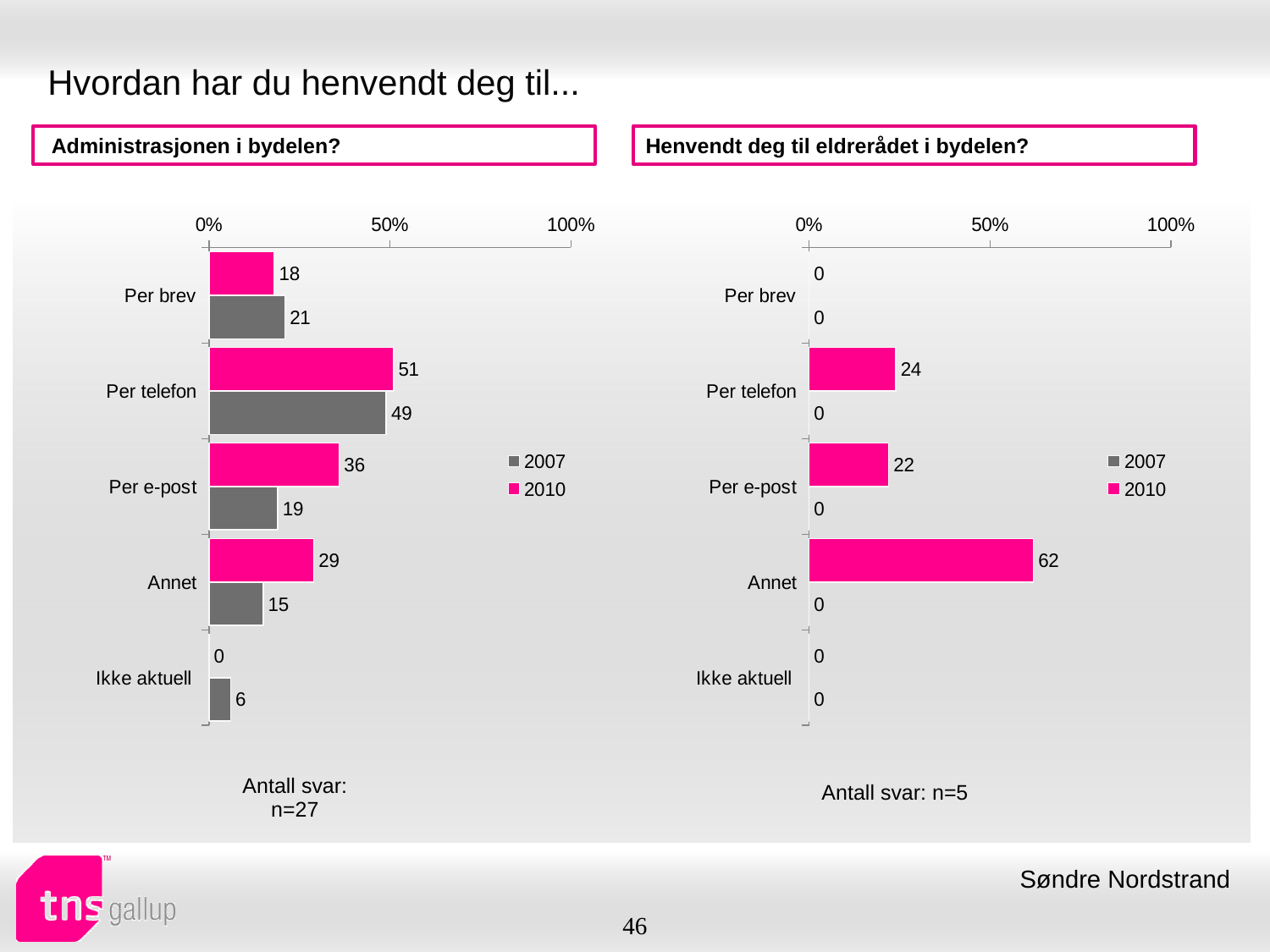
What type of chart is the left chart (Administrasjonen i bydelen?)? Bar chart In the left chart (Administrasjonen i bydelen?), which category has the lowest 2007 value? Ikke aktuell In the left chart (Administrasjonen i bydelen?), which category has the highest 2010 value? Per telefon In the right chart (Henvendt deg til eldrerådet i bydelen?), what is the difference between the 2010 values for Per telefon and Per e-post? 2 In the left chart (Administrasjonen i bydelen?), which is larger for Annet: the 2007 value or the 2010 value? 2010 How many categories are shown in the right chart (Henvendt deg til eldrerådet i bydelen?)? 5 In the left chart (Administrasjonen i bydelen?), what is the 2007 value for Per e-post? 19 How many series does the legend of the left chart (Administrasjonen i bydelen?) list? 2 In the left chart (Administrasjonen i bydelen?), what is the 2010 value for Per telefon? 51 In the right chart (Henvendt deg til eldrerådet i bydelen?), what is the 2010 value for Annet? 62 In the right chart (Henvendt deg til eldrerådet i bydelen?), which category has the highest 2010 value? Annet In the left chart (Administrasjonen i bydelen?), what is the difference between the 2010 and 2007 values for Per e-post? 17